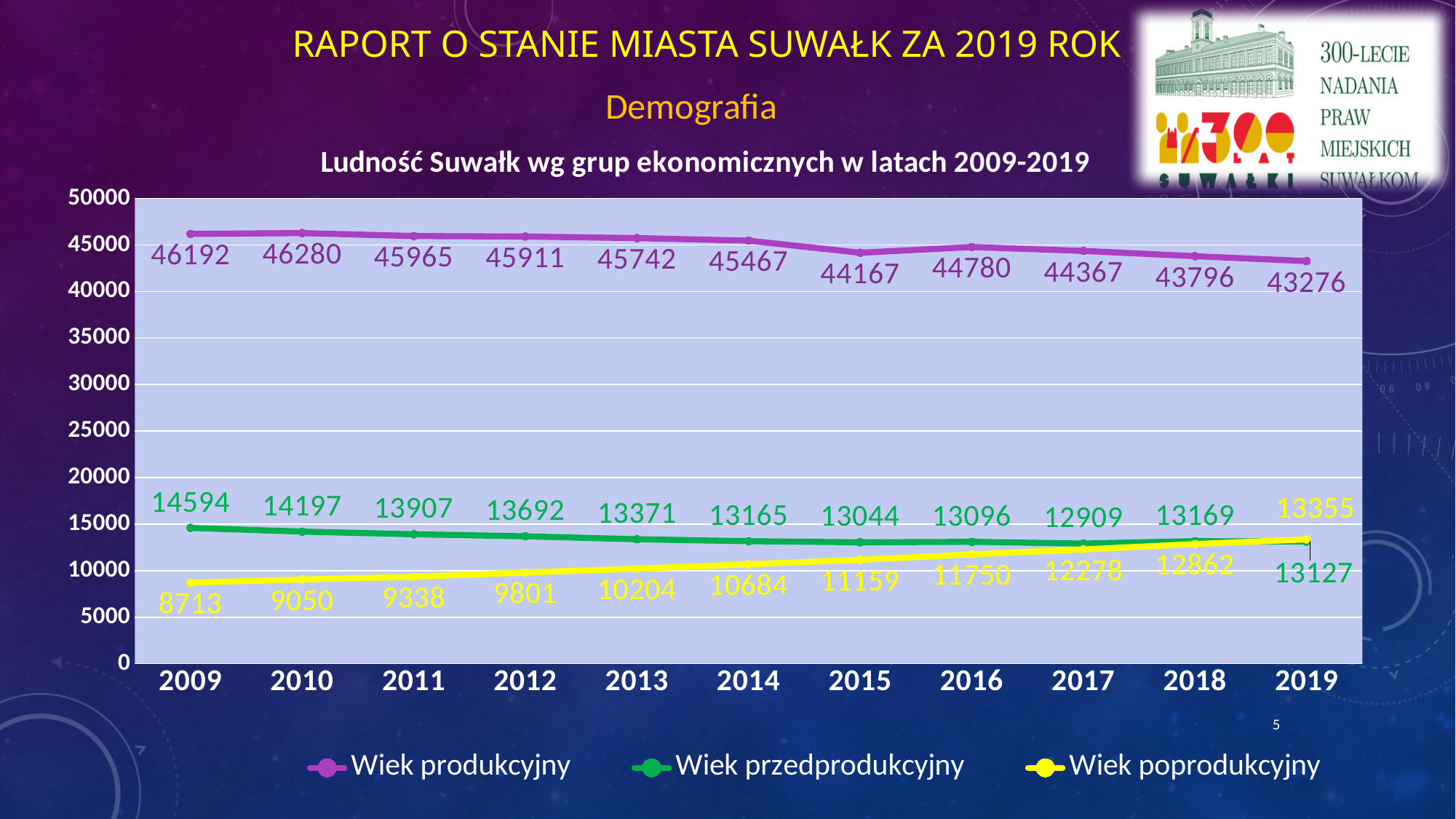
What kind of chart is shown on the slide? line chart By how much did Wiek produkcyjny decrease from 2009 to 2019? 2916 In which year is Wiek przedprodukcyjny lowest? 2017 What is the value for Wiek poprodukcyjny in 2009? 8713 What is the value for Wiek produkcyjny in 2019? 43276 In 2019, which is larger: Wiek przedprodukcyjny or Wiek poprodukcyjny? Wiek poprodukcyjny By how much did Wiek poprodukcyjny increase from 2009 to 2019? 4642 How many series does the legend list? 3 What is the value for Wiek przedprodukcyjny in 2013? 13371 Does Wiek poprodukcyjny rise or fall from 2009 to 2019? rise In which year is Wiek produkcyjny highest? 2010 How many years are shown on the x axis? 11